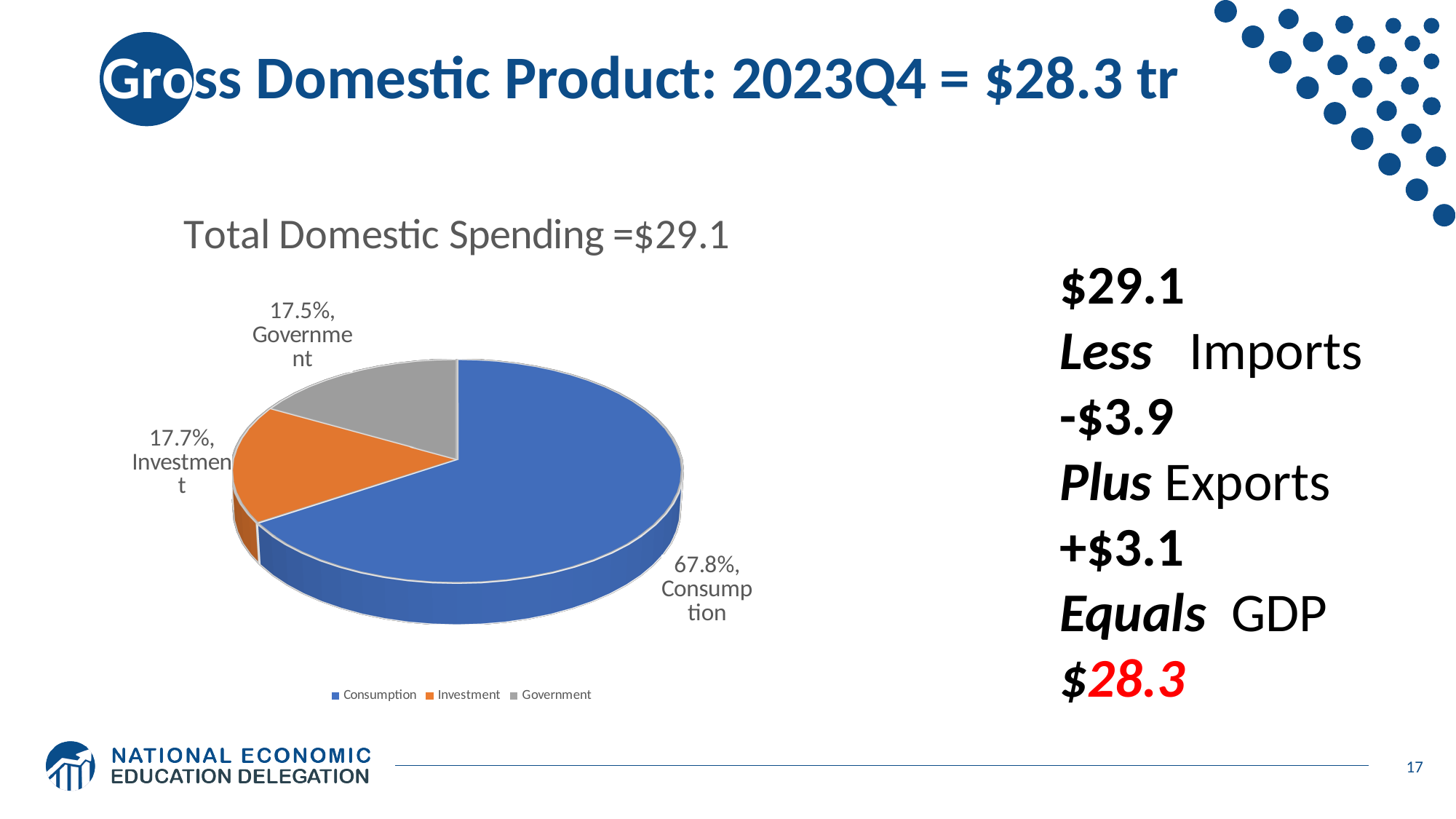
What colour is the Investment slice in the pie chart? Orange What share of the pie does Consumption represent? 67.8% How many categories are shown in the pie chart? 3 What is the title of the chart? Total Domestic Spending =$29.1 How many entries does the chart legend list? 3 Which category has the largest slice of the pie? Consumption What is the difference in percentage points between the Consumption and Investment shares? 50.1 What share of the pie does Investment represent? 17.7% Which is larger, the Consumption share or the Investment share? Consumption What kind of chart is shown on the slide? Pie chart What share of the pie does Government represent? 17.5% What is the difference in percentage points between the Consumption and Government shares? 50.3